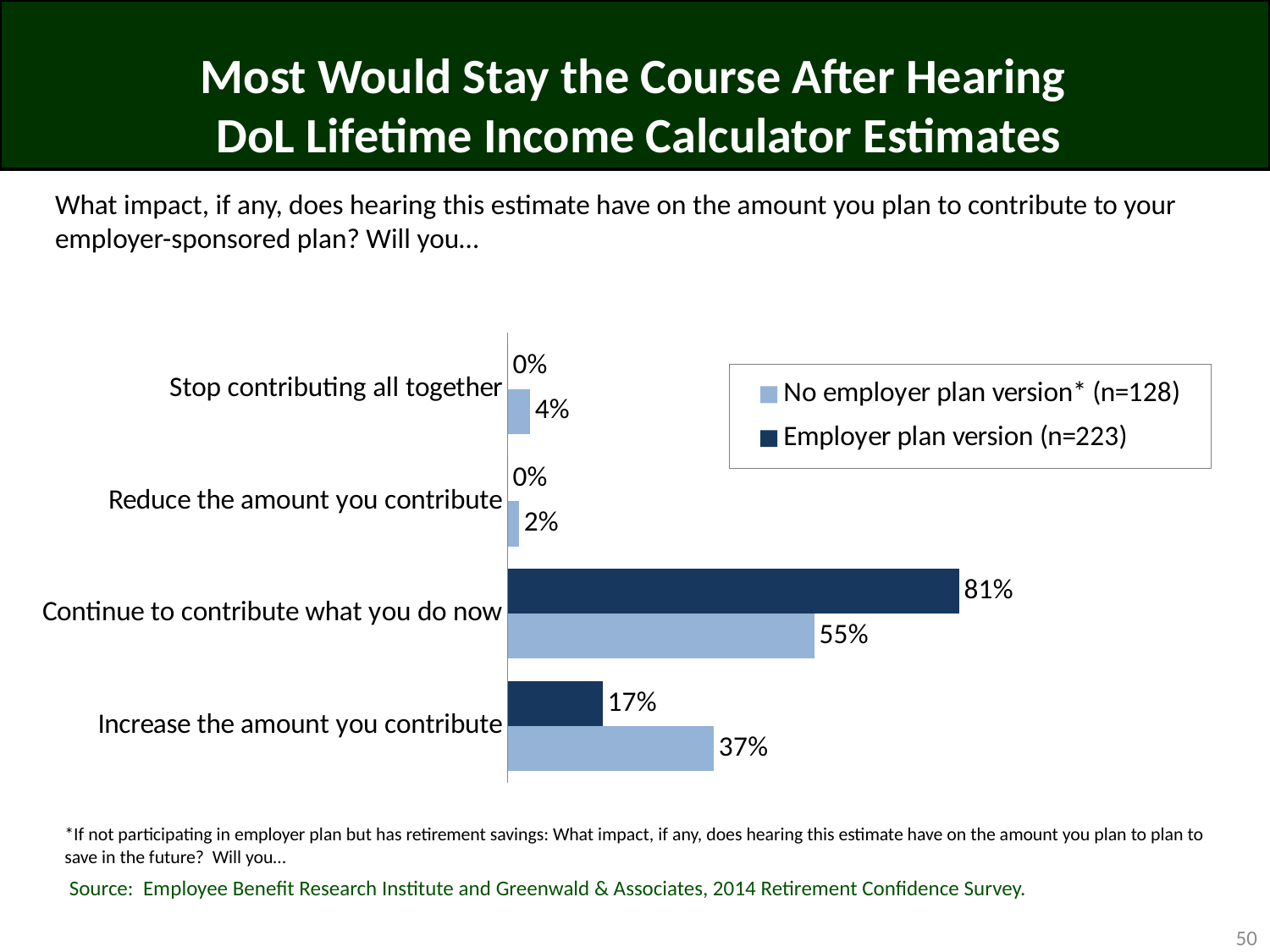
For 'Increase the amount you contribute', which series has the larger value: Employer plan version or No employer plan version? No employer plan version What percentage of the Employer plan version respondents would continue to contribute what they do now? 81% How many series does the legend list? 2 What percentage of the No employer plan version respondents would increase the amount they contribute? 37% How many response categories are shown on the chart? 4 What kind of chart is shown on the slide? Bar chart What percentage of the Employer plan version respondents would reduce the amount they contribute? 0% What is the difference between the Employer plan version and No employer plan version values for 'Continue to contribute what you do now'? 26 percentage points What percentage of the No employer plan version respondents would stop contributing all together? 4% Which response category has the lowest value for the No employer plan version series? Reduce the amount you contribute What is the sample size (n) shown in the legend for the Employer plan version series? 223 Which response category has the highest value for the No employer plan version series? Continue to contribute what you do now